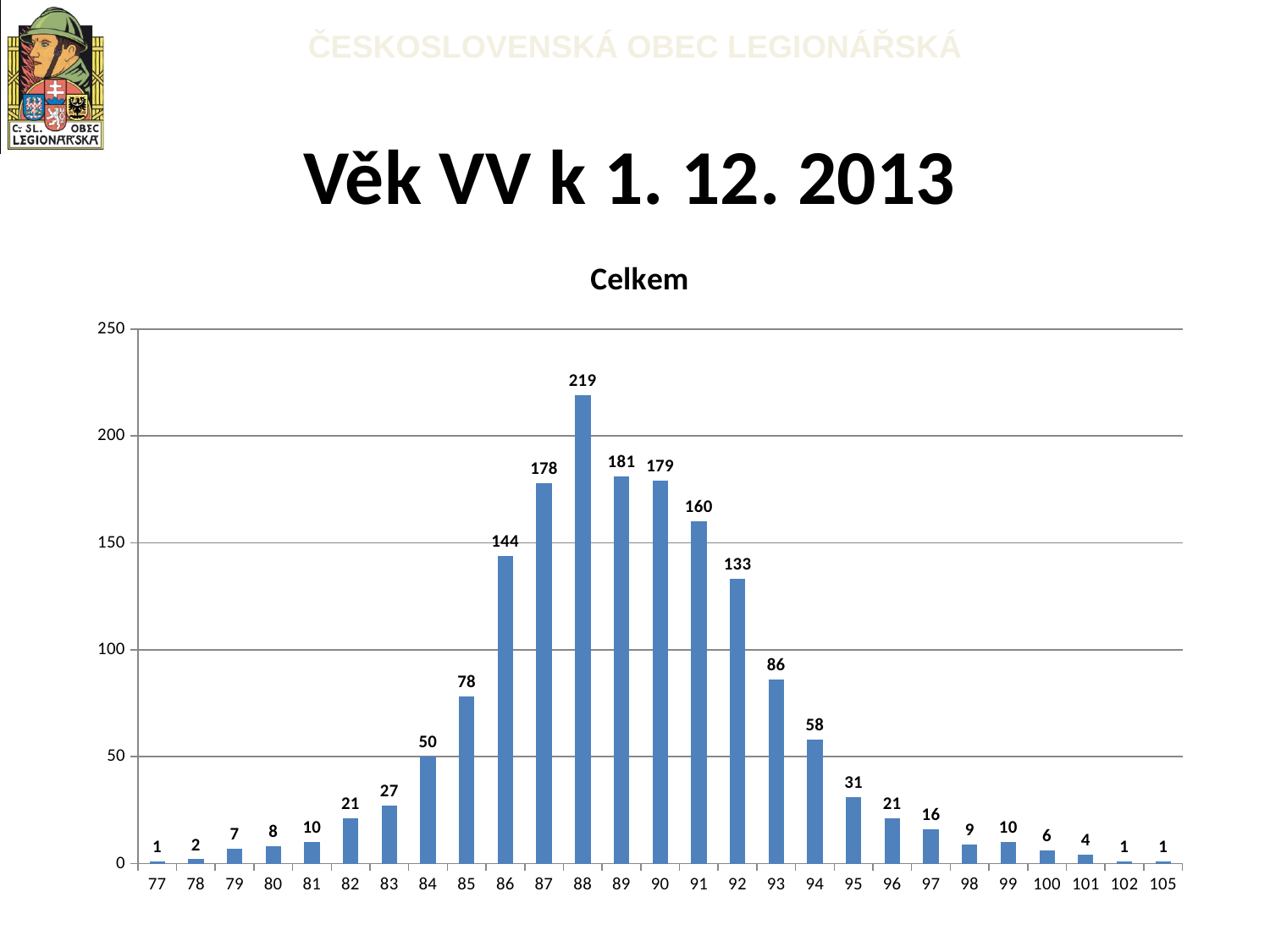
What is the value for age 88 in the Celkem chart? 219 What is the value for age 93 in the Celkem chart? 86 What kind of chart is shown on the slide? bar chart How many age categories are shown on the x axis? 27 What is the difference between the values for age 88 and age 89? 38 What is the difference between the values for age 86 and age 85? 66 Which age category has the highest value in the chart? 88 What is the value for age 85 in the Celkem chart? 78 Is the value for age 91 greater or less than 150? greater Do the values rise or fall along the x axis from age 88 to age 105? fall Which is larger, the value for age 89 or the value for age 90? 89 What is the title of the chart? Celkem